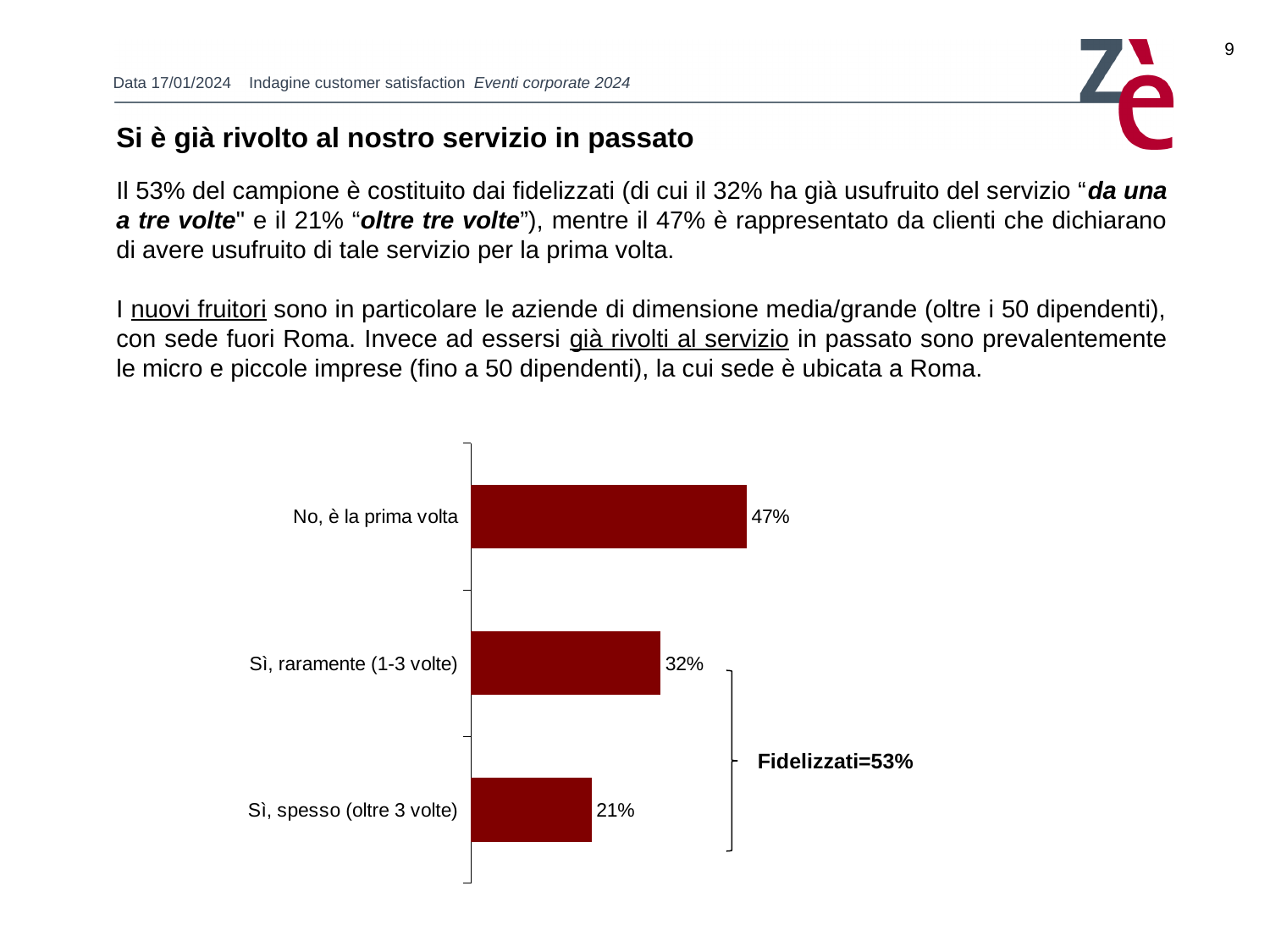
What is the value for "Sì, raramente (1-3 volte)"? 32% What is the value for "Sì, spesso (oltre 3 volte)"? 21% What is the value for "No, è la prima volta"? 47% What is the combined value of the two "Sì" categories, as labelled on the chart? 53% What is the difference between the values for "Sì, raramente (1-3 volte)" and "Sì, spesso (oltre 3 volte)"? 11% What is the difference between the values for "No, è la prima volta" and "Sì, spesso (oltre 3 volte)"? 26% Which category has the lowest value? Sì, spesso (oltre 3 volte) Which is larger, the value for "Sì, raramente (1-3 volte)" or for "Sì, spesso (oltre 3 volte)"? Sì, raramente (1-3 volte) What kind of chart is shown on the slide? Bar chart What colour are the bars in the chart? Dark red Which category has the highest value? No, è la prima volta How many categories does the chart show? 3